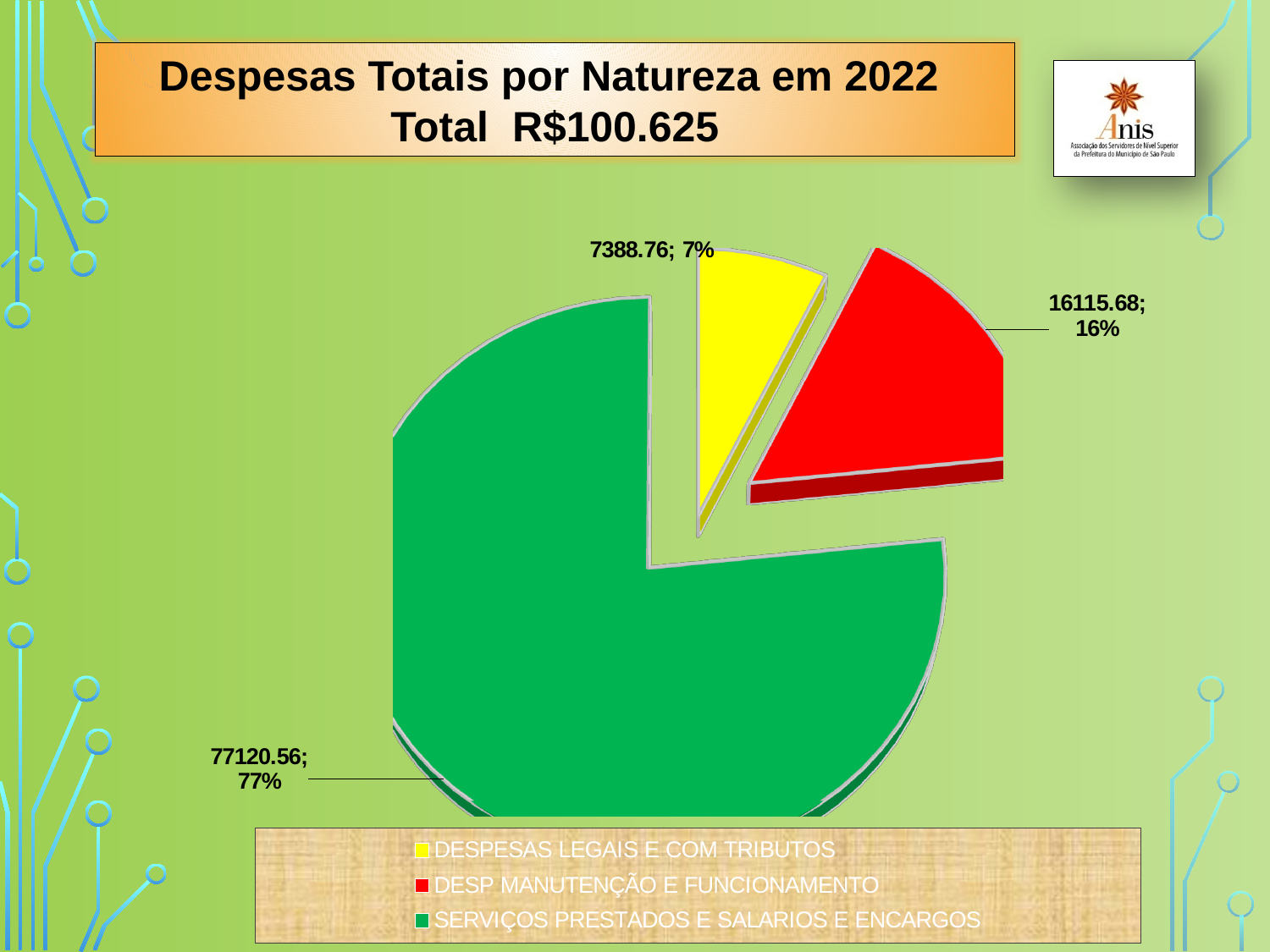
What share of the pie does SERVIÇOS PRESTADOS E SALARIOS E ENCARGOS represent? 77% What value is shown for DESPESAS LEGAIS E COM TRIBUTOS? 7388.76 What value is shown for SERVIÇOS PRESTADOS E SALARIOS E ENCARGOS? 77120.56 Which category has the smallest slice of the pie? DESPESAS LEGAIS E COM TRIBUTOS What share of the pie does DESPESAS LEGAIS E COM TRIBUTOS represent? 7% Which category has the largest slice of the pie? SERVIÇOS PRESTADOS E SALARIOS E ENCARGOS Which is larger, the value for DESP MANUTENÇÃO E FUNCIONAMENTO or the value for DESPESAS LEGAIS E COM TRIBUTOS? DESP MANUTENÇÃO E FUNCIONAMENTO What kind of chart is shown on the slide? Pie chart How many categories does the pie chart show? 3 What is the difference between the values for DESP MANUTENÇÃO E FUNCIONAMENTO and DESPESAS LEGAIS E COM TRIBUTOS? 8726.92 What share of the pie does DESP MANUTENÇÃO E FUNCIONAMENTO represent? 16% What value is shown for DESP MANUTENÇÃO E FUNCIONAMENTO? 16115.68